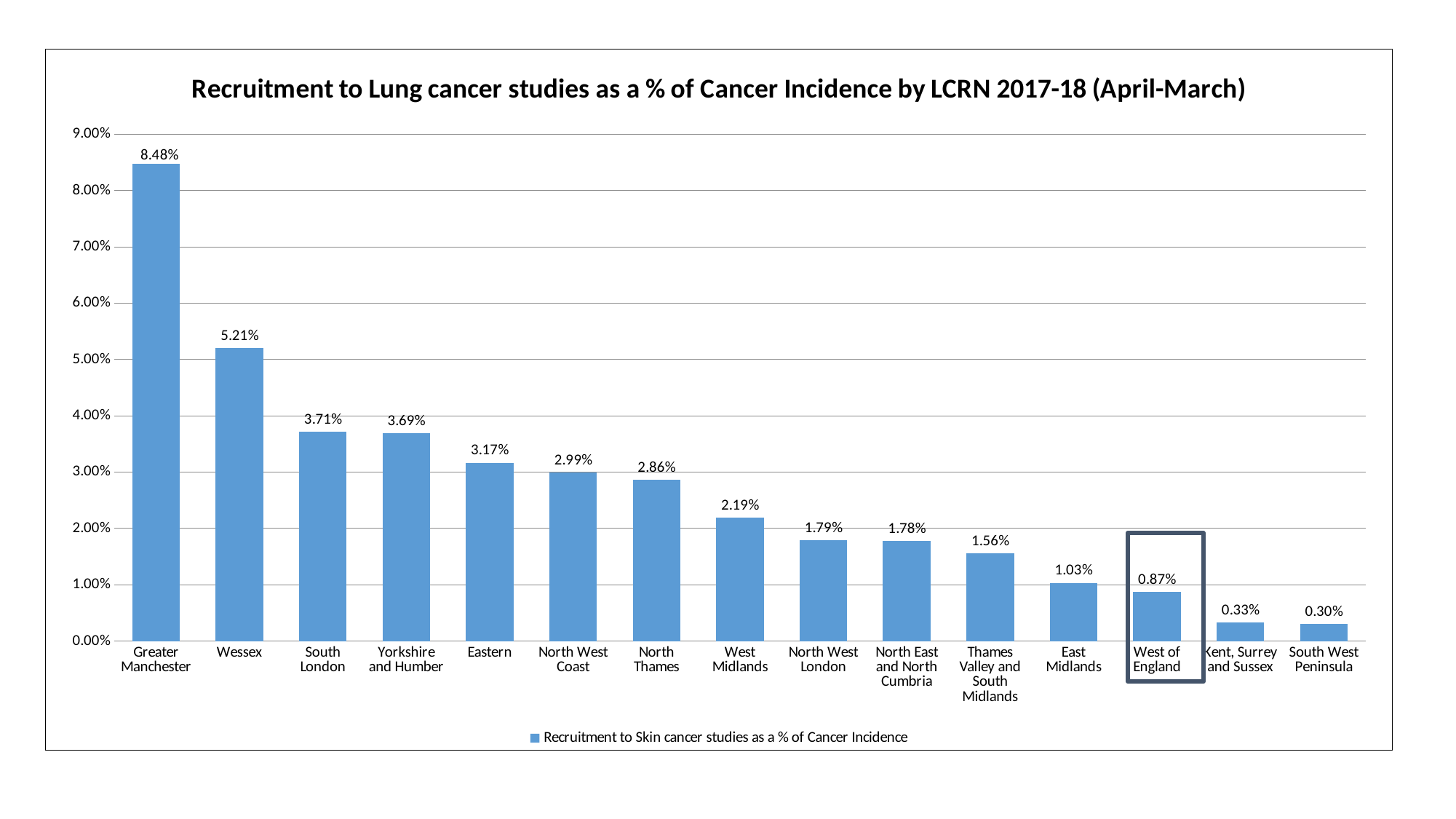
What is the difference between the values for East Midlands and West of England? 0.16% How many series does the legend list? 1 What is the value for West of England? 0.87% Do the values rise or fall from left to right along the x axis? Fall What is the difference between the values for Greater Manchester and Wessex? 3.27% Which LCRN has the lowest value? South West Peninsula Which LCRN has the highest value? Greater Manchester How many LCRNs are shown on the x axis? 15 What is the value for Thames Valley and South Midlands? 1.56% What kind of chart is this? Bar chart What is the value for Greater Manchester? 8.48% Which is larger, the value for Wessex or the value for South London? Wessex